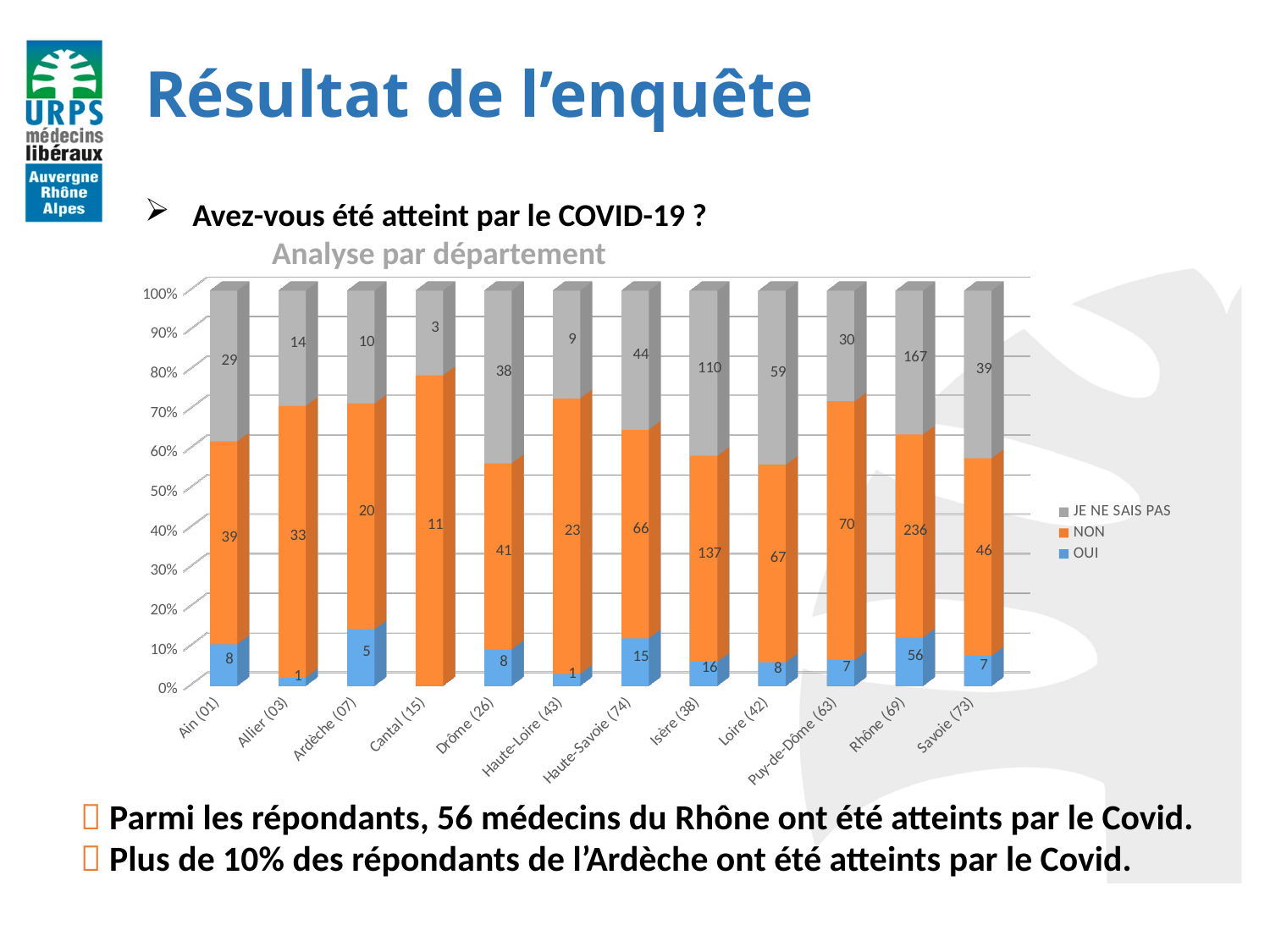
Which department has the highest value for OUI? Rhône (69) What is the difference between the NON and JE NE SAIS PAS values for Rhône (69)? 69 What is the value of JE NE SAIS PAS for Isère (38)? 110 How many departments are shown on the x axis? 12 Which department has the lowest value for NON? Cantal (15) What is the value of OUI for Haute-Savoie (74)? 15 How many series does the legend list? 3 Which is larger, the NON value for Isère (38) or the NON value for Loire (42)? Isère (38) What kind of chart is shown on the slide? Stacked bar chart What is the total of the three values in the bar for Isère (38)? 263 What is the title of the chart? Analyse par département What is the value of NON for Rhône (69)? 236